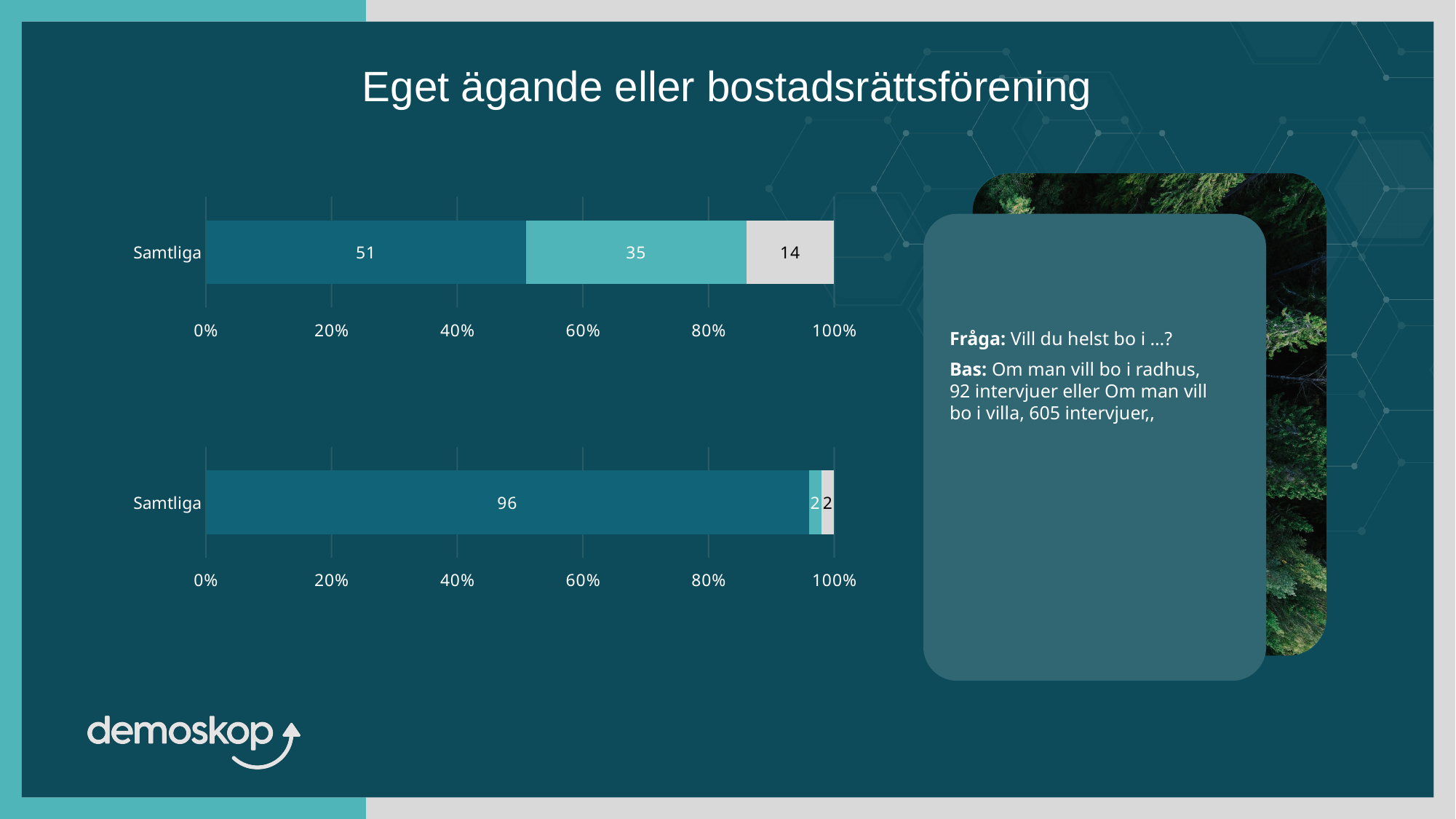
In the top chart, which segment of the Samtliga bar is the largest? The first (dark teal) segment, 51 In the top chart, what is the value of the first (dark teal) segment for Samtliga? 51 In the top chart, what is the total of the stacked bar for Samtliga? 100 In the bottom chart, what is the value of the first (dark teal) segment for Samtliga? 96 What is the title of the slide? Eget ägande eller bostadsrättsförening In the top chart, what is the value of the grey segment for Samtliga? 14 What kind of chart is shown on the slide? Stacked bar chart In the bottom chart, what is the total of the stacked bar for Samtliga? 100 In the top chart, what is the value of the middle (light teal) segment for Samtliga? 35 Is the first segment in the bottom chart larger or smaller than the first segment in the top chart? larger In the top chart, which segment of the Samtliga bar is the smallest? The grey segment, 14 In the top chart, what is the difference between the first segment (51) and the grey segment (14)? 37